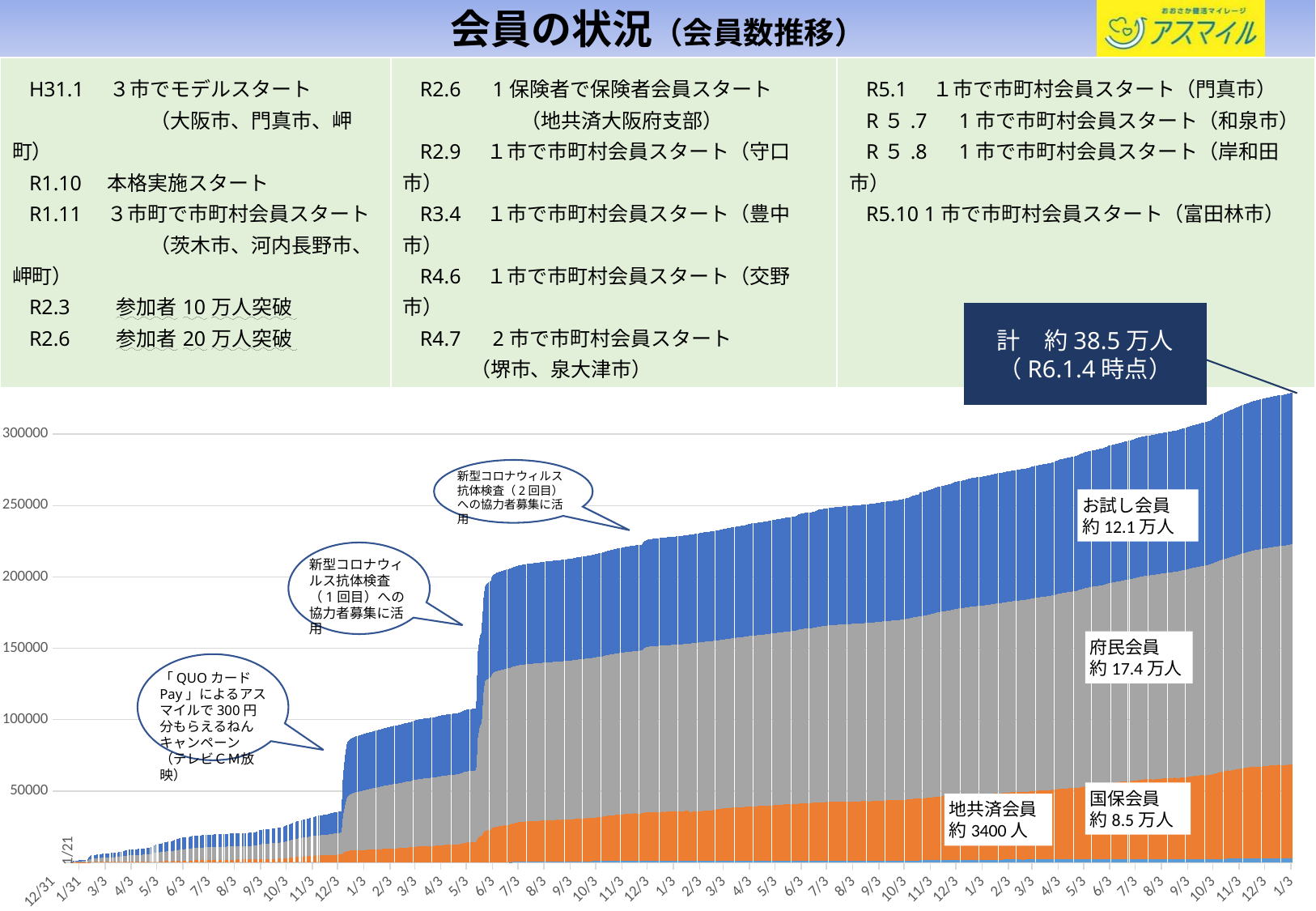
Is the total member count at the right end of the chart (1/3) greater or less than 300000? greater Do the total member counts rise or fall along the x axis over time? rise Which member category has the smallest labelled count? 地共済会員 What is the total number of members shown as of R6.1.4? 約38.5万人 What is the labelled number of お試し会員 on the chart? 約12.1万人 What is the title of the slide containing the chart? 会員の状況（会員数推移） What is the labelled number of 地共済会員 on the chart? 約3400人 Which member category has the largest labelled count? 府民会員 Which is larger, the labelled count for 府民会員 or for お試し会員? 府民会員 What kind of chart is shown on the slide? stacked bar chart What is the labelled number of 国保会員 on the chart? 約8.5万人 What is the labelled number of 府民会員 on the chart? 約17.4万人